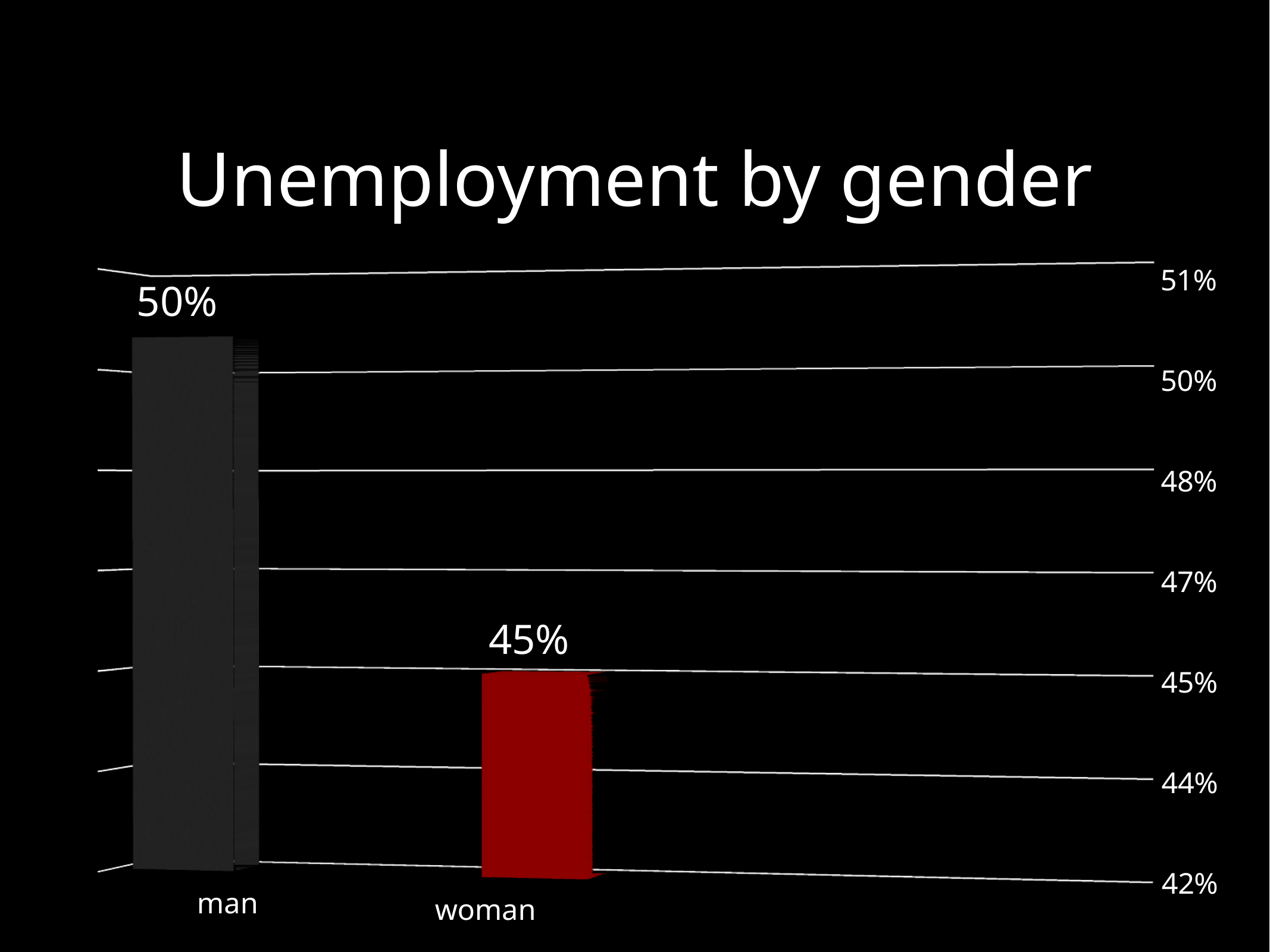
What kind of chart is shown on the slide? bar chart What is the unemployment value for woman? 45% Is the value for man greater or less than 47%? greater Is the value for woman greater or less than 48%? less What is the difference between the unemployment values for man and woman? 5% Which is larger, the value for man or the value for woman? man What colour is the bar for woman? red What is the unemployment value for man? 50% How many categories are shown in the chart? 2 What is the title of the chart? Unemployment by gender Which category has the lowest unemployment value? woman Which category has the highest unemployment value? man